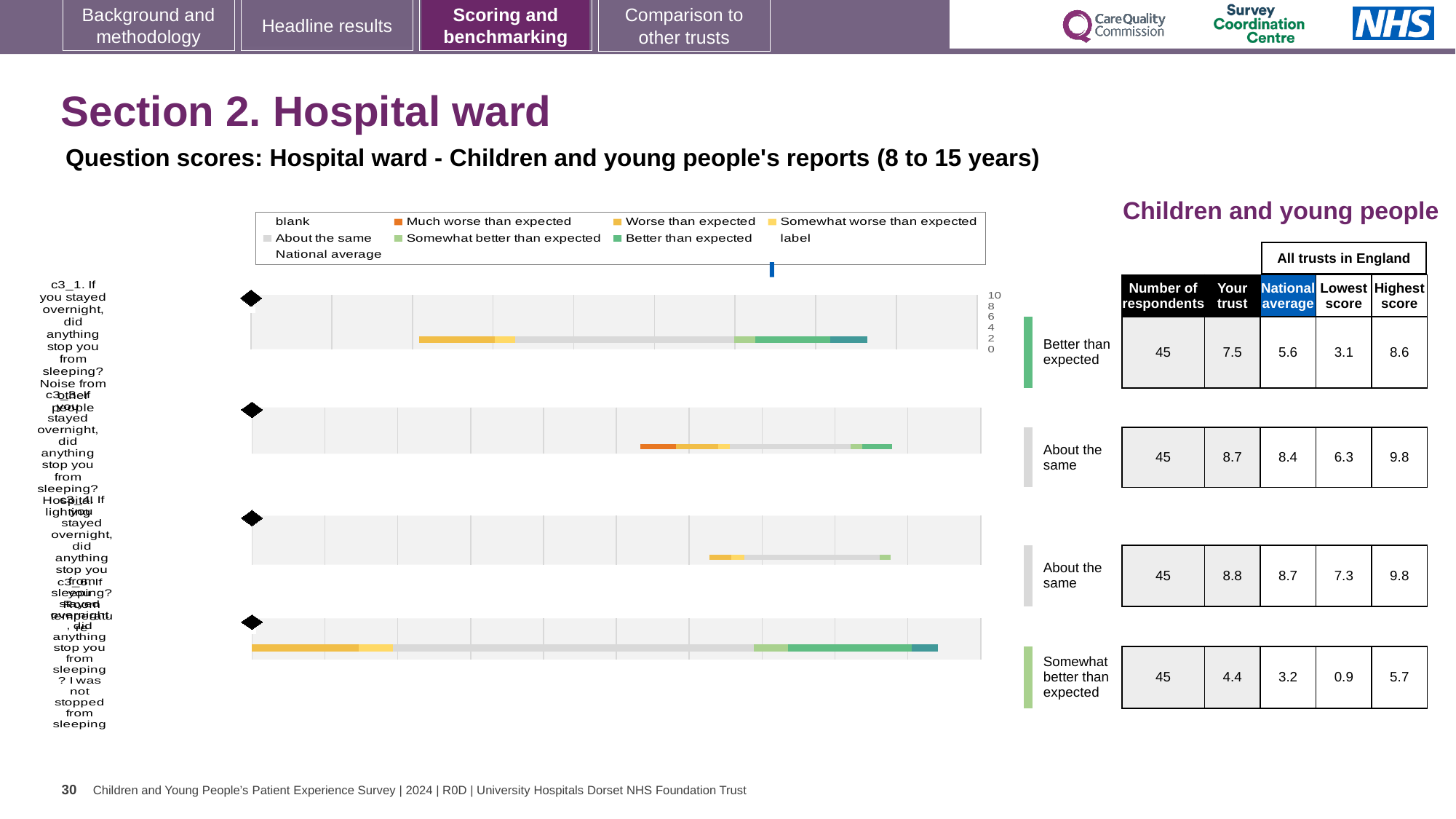
For the fourth (bottom) chart, what benchmark category is shown beside it? Somewhat better than expected How many question-score bar charts are shown on the slide? 4 For the first chart (c3_1, noise from other people), what is the difference between the 'Your trust' score and the national average? 1.9 For the fourth (bottom) chart, what is the lowest score among all trusts in England? 0.9 For the first chart (c3_1, noise from other people), what benchmark category is shown beside it? Better than expected For the fourth (bottom) chart, what is the 'Your trust' score shown in the table? 4.4 For the second chart, is the 'Your trust' score (8.7) larger or smaller than the national average (8.4)? larger For the first chart (c3_1, noise from other people), what is the national average score shown in the table? 5.6 For the first chart (c3_1, noise from other people), what is the 'Your trust' score shown in the table? 7.5 What is the title of the slide section containing the charts? Section 2. Hospital ward In the chart legend, what colour represents 'Much worse than expected'? orange What kind of chart is used for the four question-score charts on the slide? bar chart